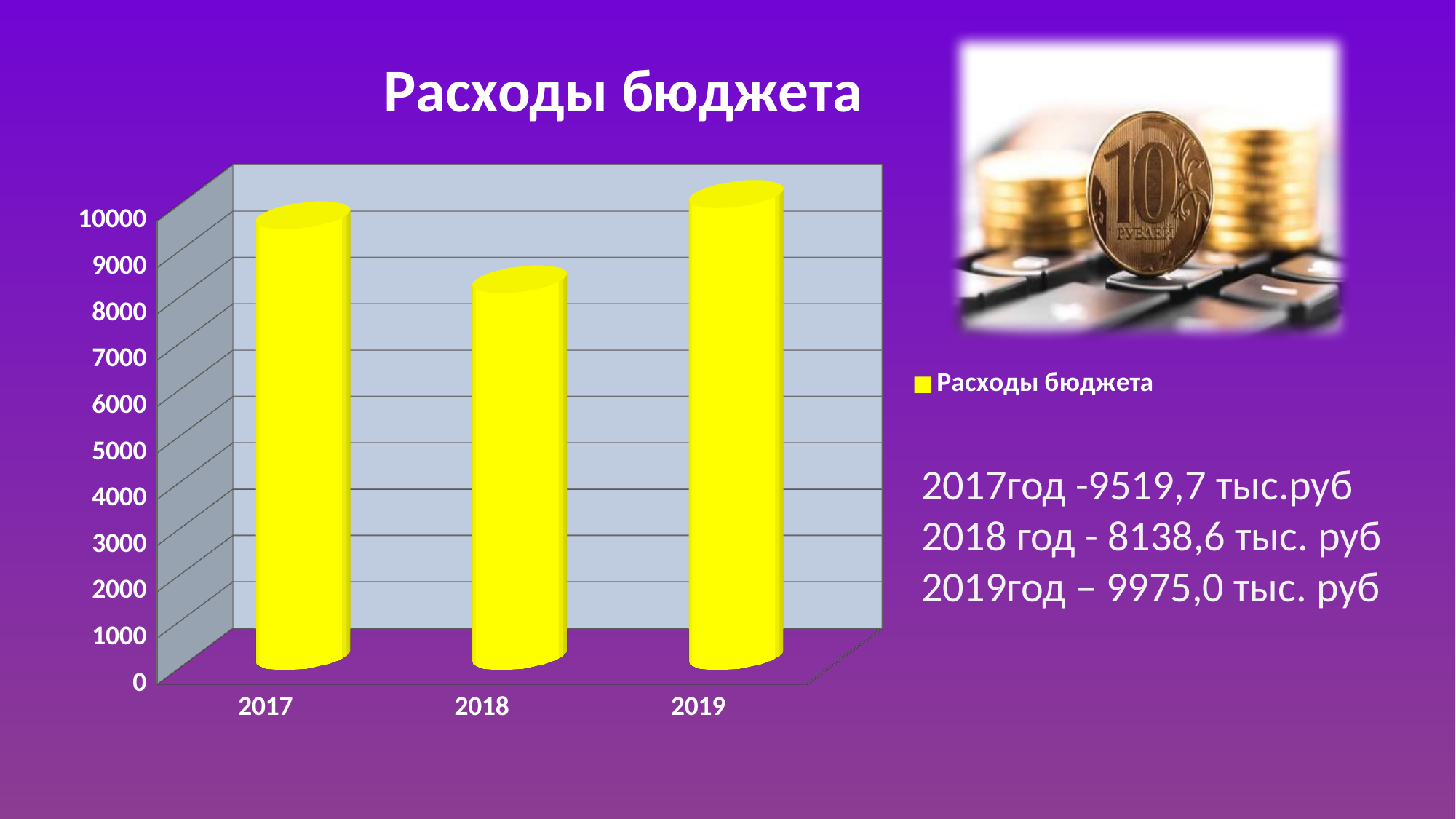
What is the budget expenditure value for 2017? 9519,7 тыс.руб Which year has the lowest budget expenditure? 2018 How many series does the chart legend list? 1 What is the difference between the budget expenditure for 2019 and for 2018? 1836,4 тыс. руб What is the budget expenditure value for 2018? 8138,6 тыс. руб What kind of chart is shown on the slide? bar chart Is the value for 2018 greater or less than 9000? less Which year has the highest budget expenditure? 2019 Which is larger, the budget expenditure for 2017 or for 2018? 2017 How many years (categories) are shown on the x axis of the chart? 3 What is the title of the chart? Расходы бюджета What is the budget expenditure value for 2019? 9975,0 тыс. руб